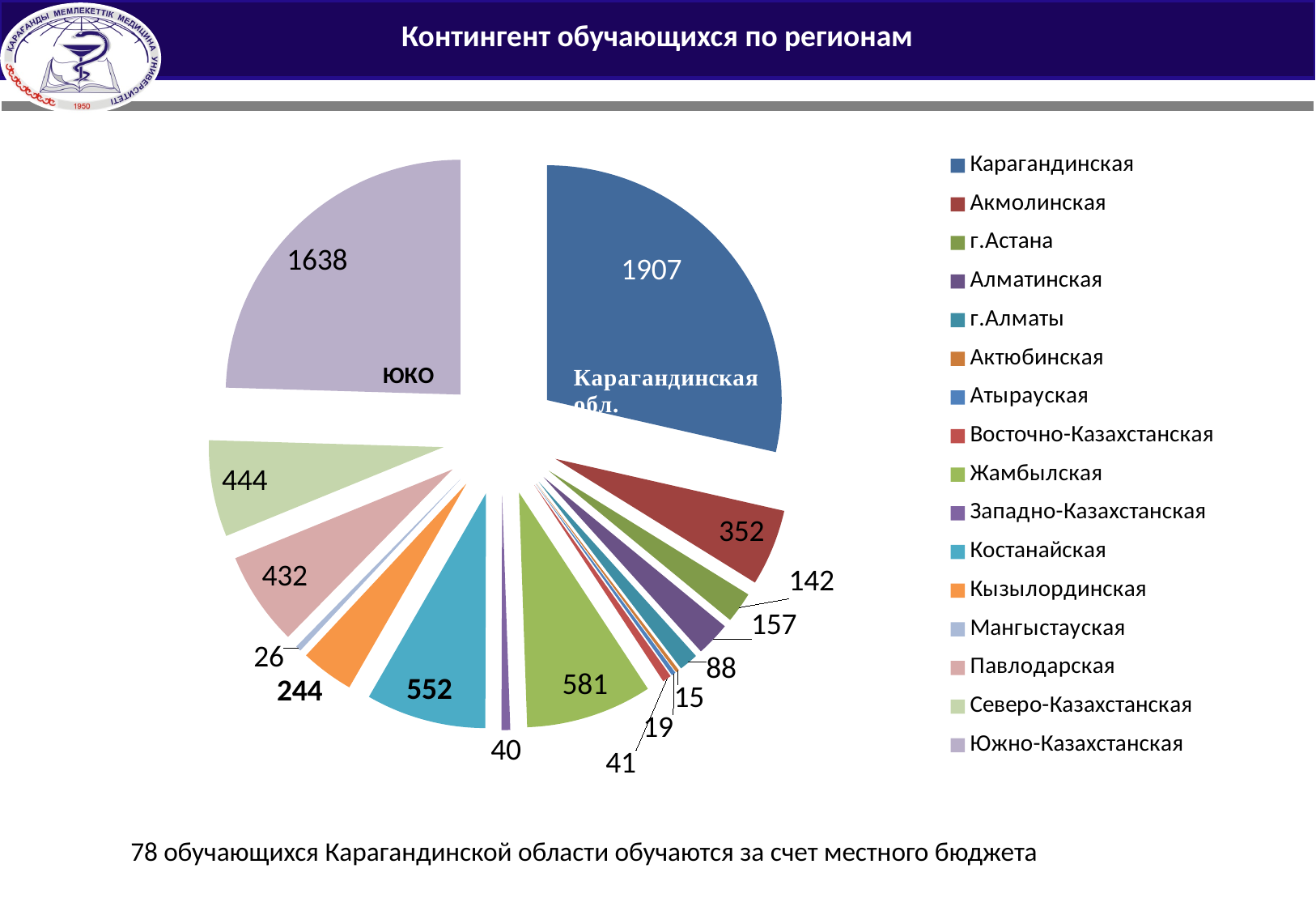
What is the value for Карагандинская in the pie chart? 1907 Which is larger, the value for Жамбылская or the value for Костанайская? Жамбылская What is the value for Южно-Казахстанская (ЮКО) in the pie chart? 1638 What is the smallest value labelled on the pie chart? 15 How many regions are listed in the legend of the pie chart? 16 What is the value for Акмолинская in the pie chart? 352 What is the difference between the values for Карагандинская and Южно-Казахстанская? 269 Which region has the largest slice in the pie chart? Карагандинская What is the value for Павлодарская in the pie chart? 432 What is the title of the slide containing the pie chart? Контингент обучающихся по регионам What kind of chart is shown on the slide? pie chart What is the value for Жамбылская in the pie chart? 581